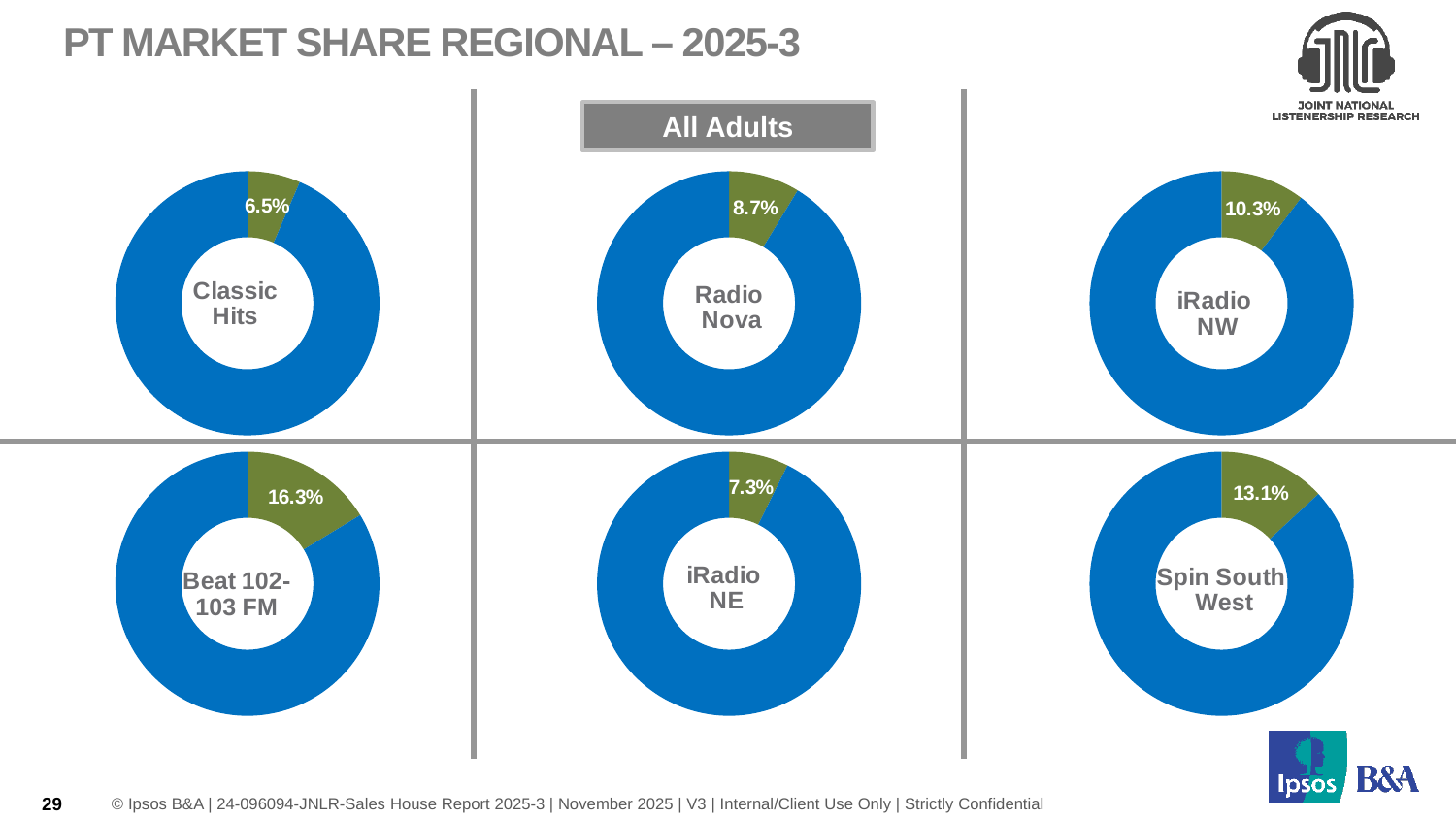
What is the difference in market share between the Beat 102-103 FM chart and the Classic Hits chart? 9.8 percentage points In the iRadio NW donut chart, what market share is shown for the green slice? 10.3% How many donut charts are shown on the slide? 6 What type of chart is used for each station on the slide? Donut (pie) chart In the iRadio NE donut chart, what market share is shown for the green slice? 7.3% Which has the larger market share, the iRadio NW chart or the iRadio NE chart? iRadio NW In the Classic Hits donut chart, what market share is shown for the green slice? 6.5% In the Spin South West donut chart, what market share is shown for the green slice? 13.1% Across the six donut charts on the slide, which station has the lowest market share? Classic Hits In the Radio Nova donut chart, what market share is shown for the green slice? 8.7% Across the six donut charts on the slide, which station has the highest market share? Beat 102-103 FM In the Beat 102-103 FM donut chart, what market share is shown for the green slice? 16.3%